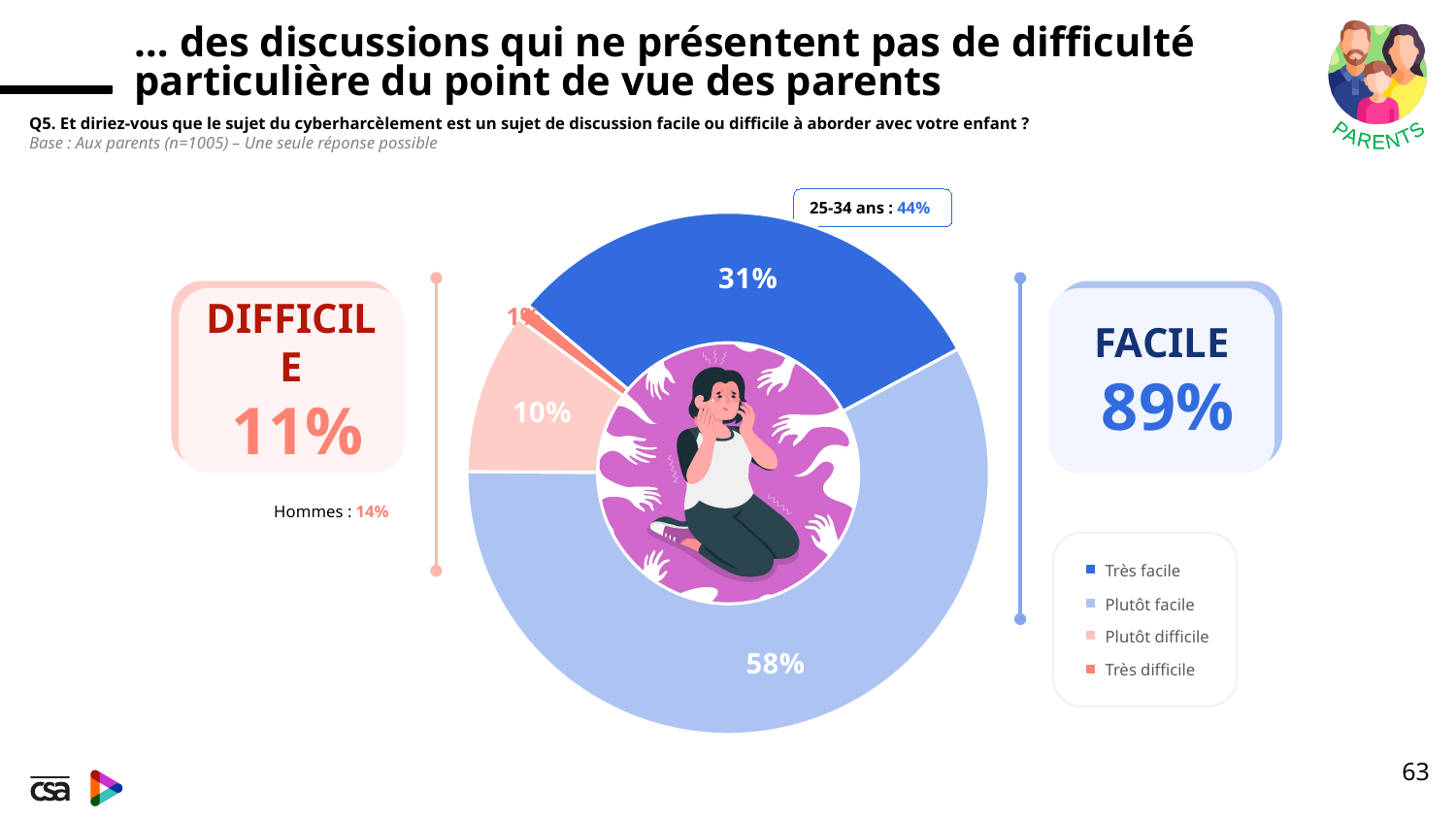
Which response category has the smallest share of the pie? Très difficile What is the combined percentage shown for "FACILE" (Très facile + Plutôt facile)? 89% What is the difference in percentage points between "Plutôt facile" and "Très facile"? 27 How many categories does the legend list? 4 What percentage is shown for "Hommes" next to the DIFFICILE box? 14% Which is larger, the share for "Très facile" or the share for "Plutôt difficile"? Très facile What percentage of parents answered "Plutôt difficile"? 10% What percentage of parents answered "Très difficile"? 1% What kind of chart is shown on the slide? Doughnut chart What percentage of parents answered "Plutôt facile"? 58% Which response category has the largest share of the pie? Plutôt facile What percentage of parents answered "Très facile"? 31%